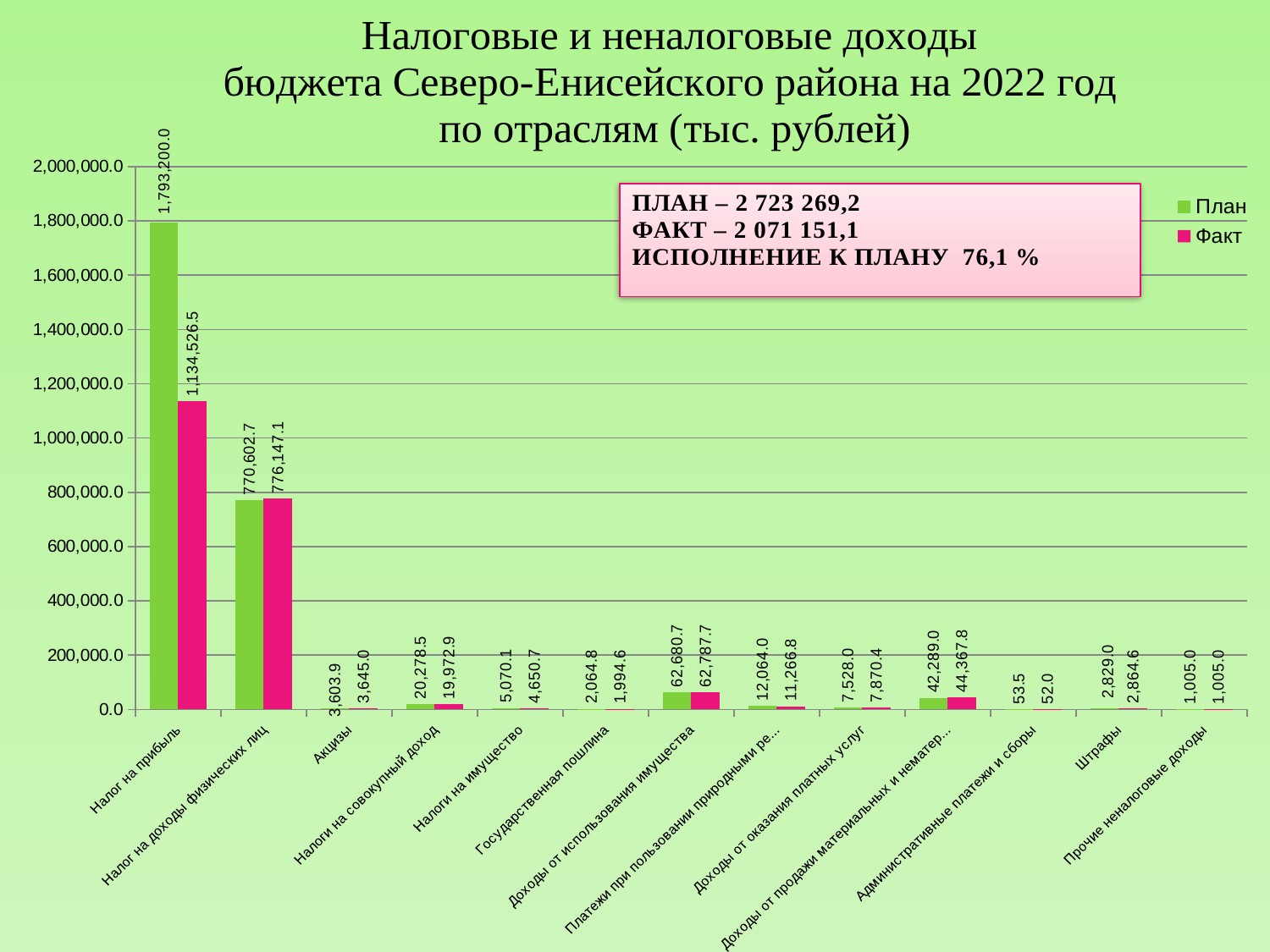
What is the Факт value for Налог на доходы физических лиц? 776,147.1 What is the difference between the План and Факт values for Налог на прибыль? 658,673.5 Which category has the lowest Факт value? Административные платежи и сборы What kind of chart is shown on the slide? bar chart Is the Факт value for Налог на прибыль greater or less than 1,200,000.0? less What is the Факт value for Доходы от использования имущества? 62,787.7 Which category has the highest План value? Налог на прибыль For Налог на доходы физических лиц, which is larger: the План value or the Факт value? Факт How many categories are shown on the x axis? 13 How many series does the legend list? 2 What is the План value for Налог на прибыль? 1,793,200.0 What is the План value for Административные платежи и сборы? 53.5